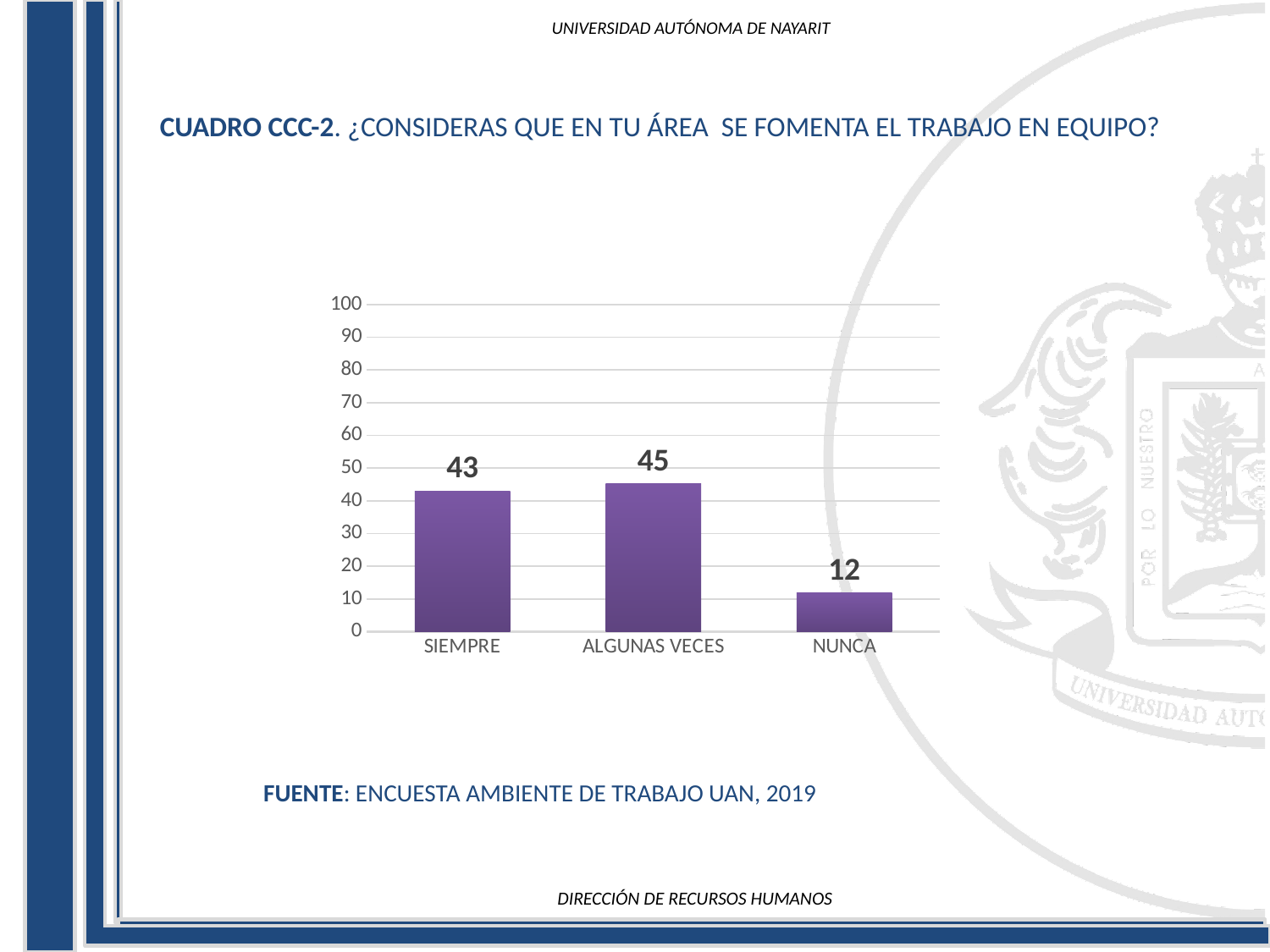
What is the highest value shown on the vertical axis? 100 Is the value for NUNCA greater or less than 20? less What kind of chart is shown on the slide? bar chart How many categories are shown on the x axis? 3 Which category has the lowest value? NUNCA Which category has the highest value? ALGUNAS VECES What is the difference between the values for ALGUNAS VECES and NUNCA? 33 What is the value for SIEMPRE? 43 Which is larger, the value for SIEMPRE or the value for NUNCA? SIEMPRE What is the value for ALGUNAS VECES? 45 What is the difference between the values for SIEMPRE and NUNCA? 31 What is the value for NUNCA? 12